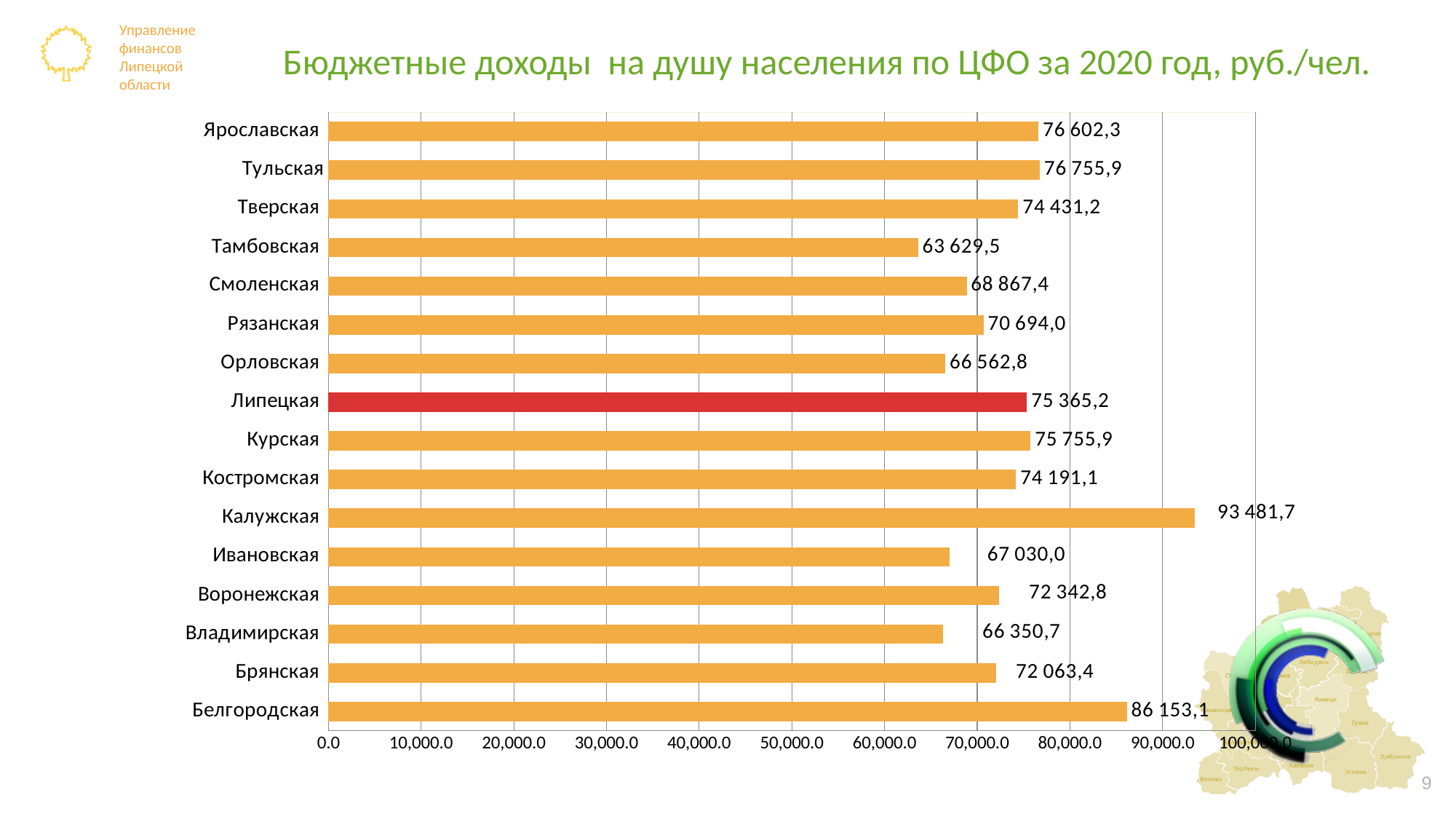
Which region has the lowest value? Тамбовская What kind of chart is shown on the slide? bar chart What is the value for Тамбовская? 63 629,5 How many regions are shown in the chart? 16 What is the difference between the values for Калужская and Белгородская? 7 328,6 Which region has the highest value? Калужская Which is larger, the value for Белгородская or the value for Ярославская? Белгородская Which region's bar is coloured red instead of orange? Липецкая What is the value for Белгородская? 86 153,1 What is the value for Липецкая? 75 365,2 What is the value for Калужская? 93 481,7 Is the value for Рязанская greater or less than 70,000.0? greater